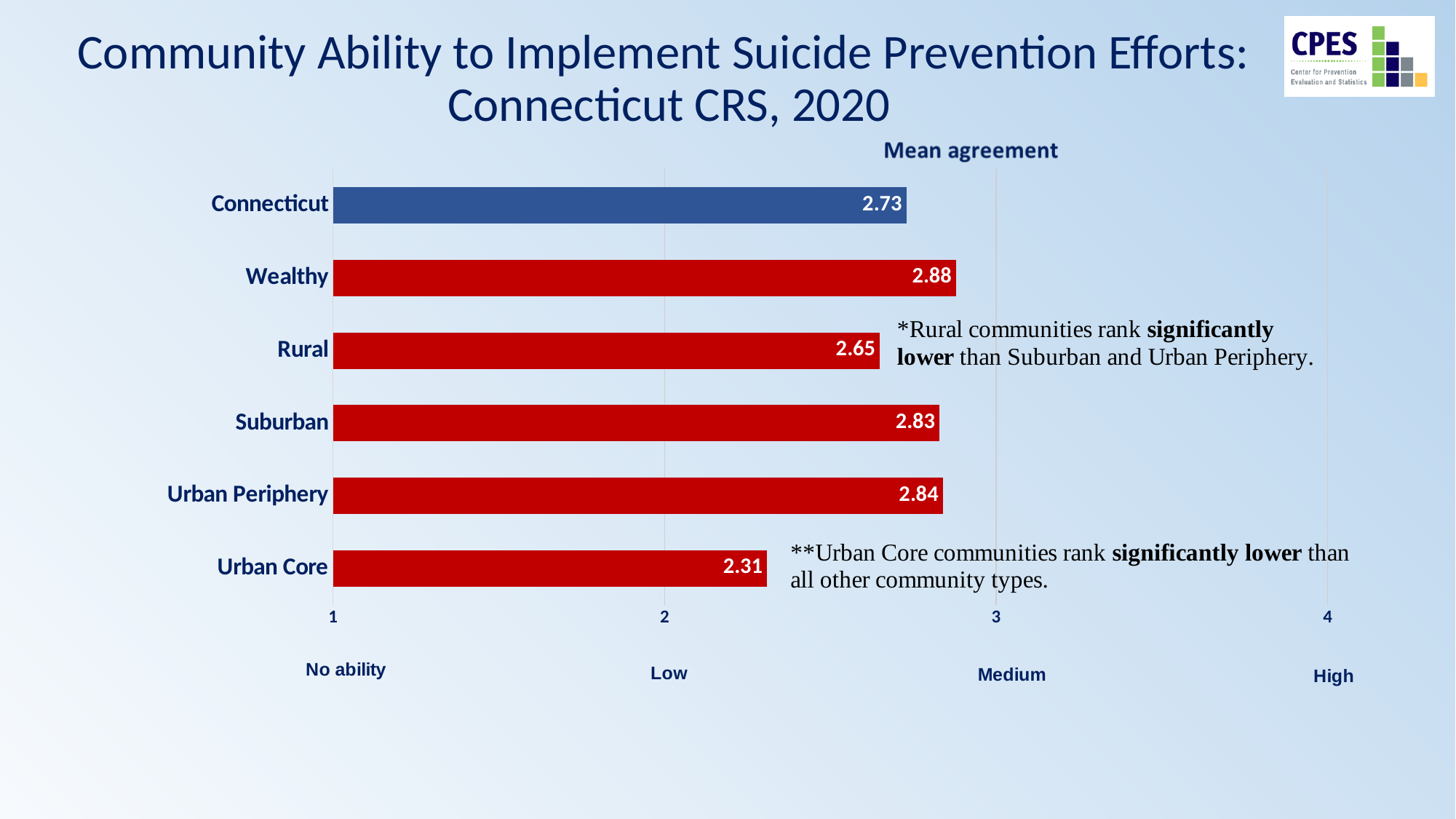
What is the difference between the mean agreement for Connecticut and Rural? 0.08 What is the mean agreement value for Suburban? 2.83 Which category has the highest mean agreement? Wealthy What is the difference between the mean agreement for Wealthy and Urban Core? 0.57 What label on the x axis corresponds to the value 3? Medium What kind of chart is shown on the slide? Bar chart How many categories are shown in the chart? 6 What is the mean agreement value for Rural? 2.65 Which category has the lowest mean agreement? Urban Core What is the mean agreement value for Urban Core? 2.31 What is the mean agreement value for Connecticut? 2.73 Which has a higher mean agreement, Suburban or Rural? Suburban